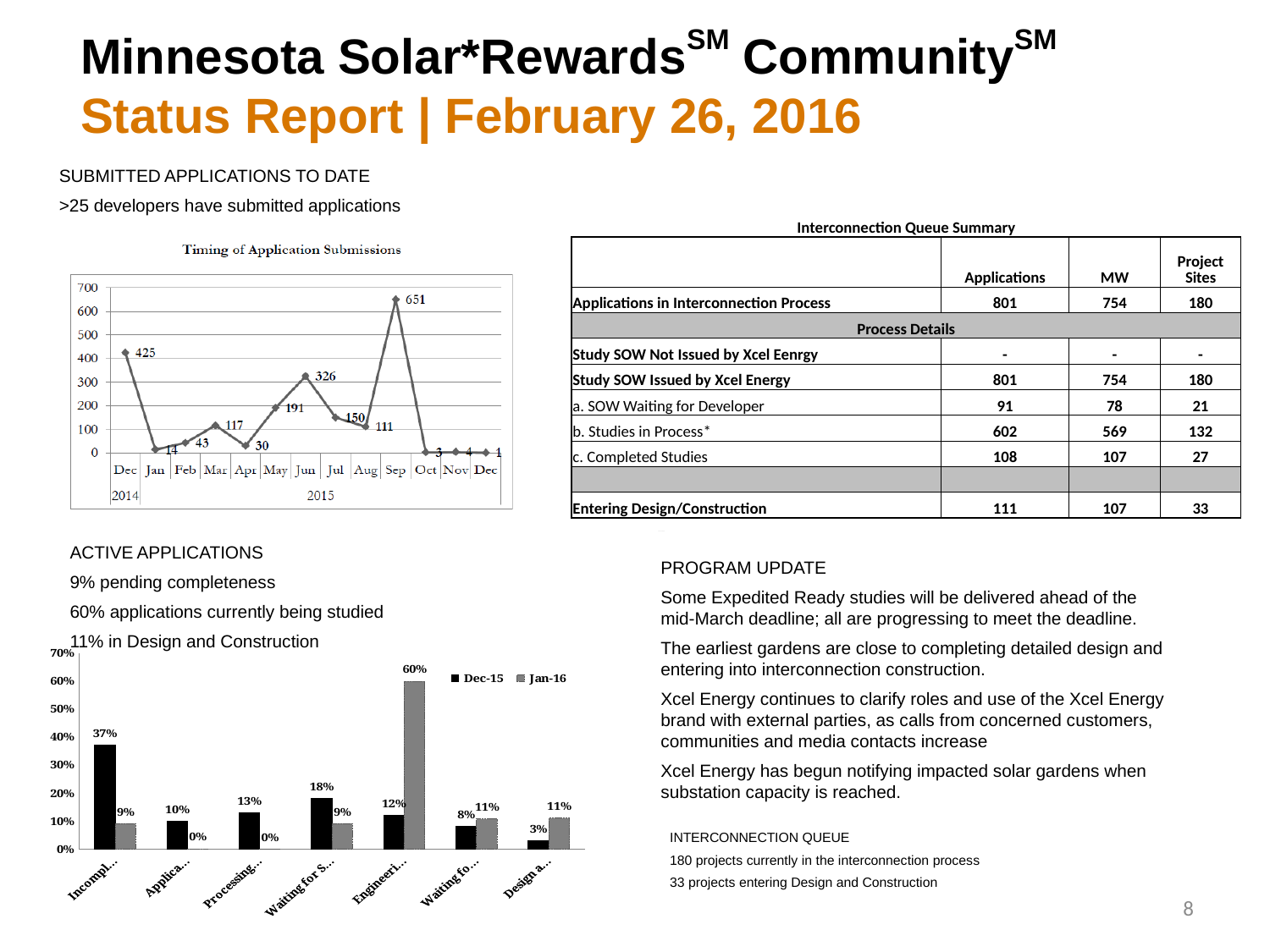
In the bar chart at the bottom left of the slide, what is the highest Jan-16 value? 60% In the bar chart at the bottom left of the slide, what is the Dec-15 value for the first category ('Incompl...')? 37% In the 'Timing of Application Submissions' chart, which is larger, the value for Mar 2015 or the value for Jul 2015? Jul 2015 In the 'Timing of Application Submissions' chart, what is the difference between the Jun 2015 and May 2015 values? 135 In the 'Timing of Application Submissions' chart, how many applications were submitted in Sep 2015? 651 In the 'Timing of Application Submissions' chart, which month has the highest number of submissions? Sep 2015 In the bar chart at the bottom left of the slide, what is the difference between the Jan-16 and Dec-15 values for the fifth category ('Engineeri...')? 48% In the bar chart at the bottom left of the slide, how many series does the legend list? 2 In the 'Timing of Application Submissions' chart, how many months are plotted? 13 In the 'Timing of Application Submissions' chart, which month has the lowest number of submissions? Dec 2015 What kind of chart is 'Timing of Application Submissions'? Line chart In the 'Timing of Application Submissions' chart, how many applications were submitted in Dec 2014? 425